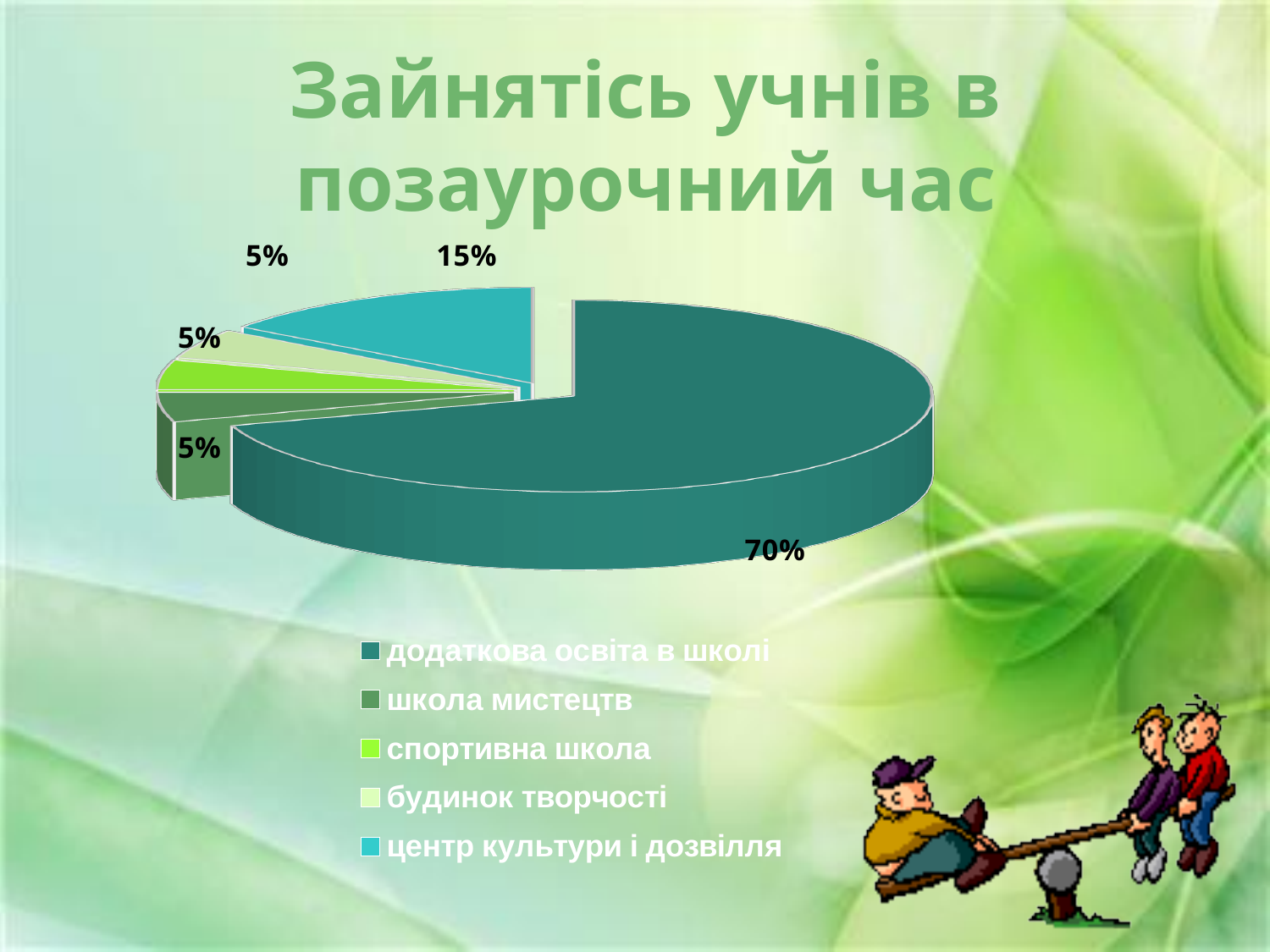
What share of the pie does 'будинок творчості' represent? 5% Which category has the largest share of the pie? додаткова освіта в школі What kind of chart is shown on the slide? pie chart What share of the pie does 'додаткова освіта в школі' represent? 70% What share of the pie does 'спортивна школа' represent? 5% Which is larger: the share for 'центр культури і дозвілля' or the share for 'спортивна школа'? центр культури і дозвілля What share of the pie does 'школа мистецтв' represent? 5% What is the smallest percentage shown on the pie chart? 5% What is the title of the slide containing the chart? Зайнятість учнів в позаурочний час How many categories does the pie chart show? 5 What share of the pie does 'центр культури і дозвілля' represent? 15% What is the difference in percentage points between 'додаткова освіта в школі' and 'центр культури і дозвілля'? 55